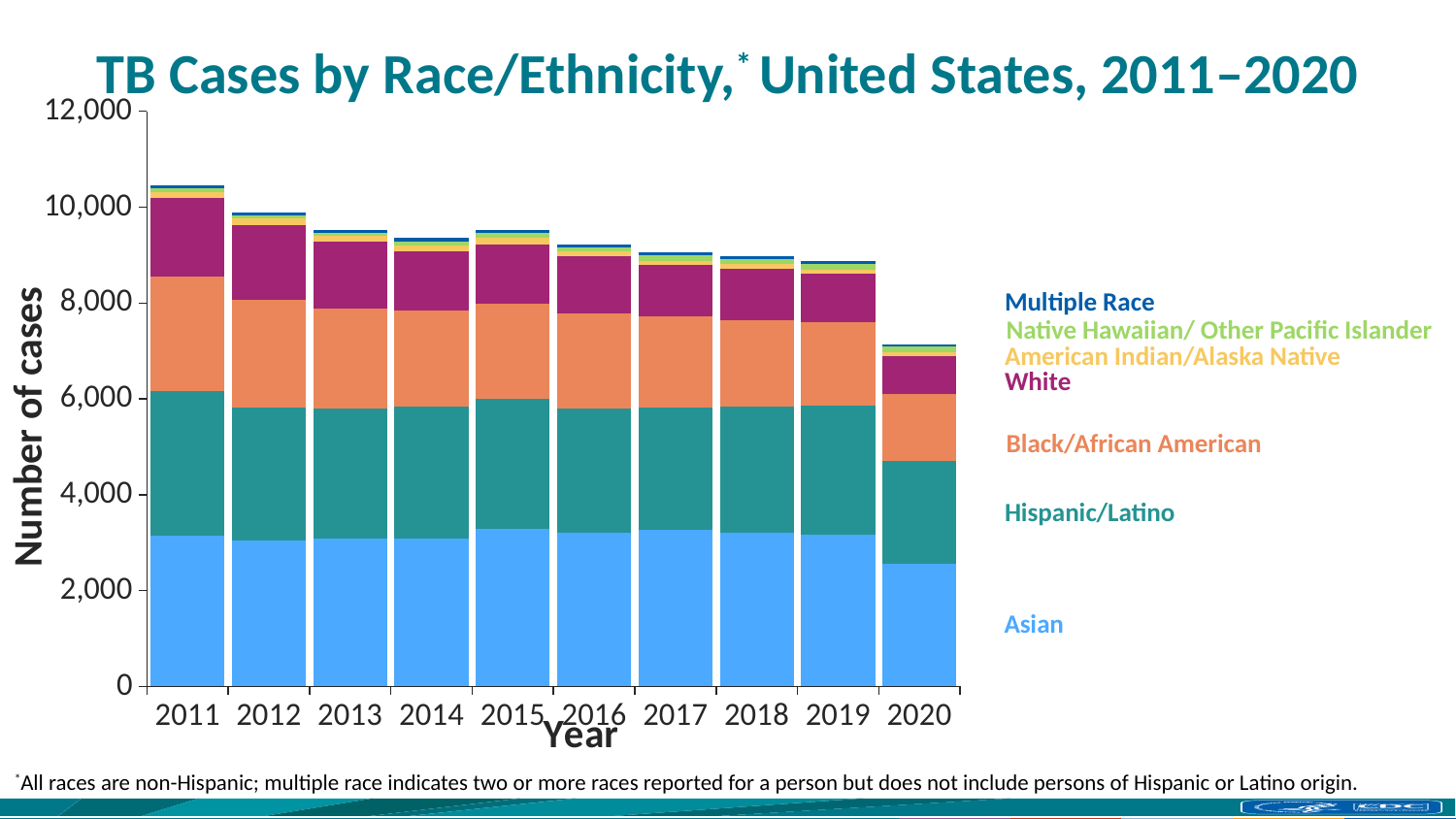
Is the total number of TB cases in 2020 greater or less than 8,000? less What is the label on the y axis of the chart? Number of cases How many years are shown along the x axis of the chart? 10 Which year has more total TB cases, 2012 or 2019? 2012 Which race/ethnicity group is shown in light blue at the bottom of each bar? Asian Do total TB cases generally rise or fall from 2011 to 2020? Fall Which year has the shortest stacked bar (fewest TB cases overall)? 2020 Is the number of Asian TB cases in 2020 greater or less than 2,000? greater How many race/ethnicity groups does the legend list? 7 Which year has the tallest stacked bar (most TB cases overall)? 2011 Is the total number of TB cases in 2011 greater or less than 10,000? greater What kind of chart is shown on the slide? Stacked bar chart